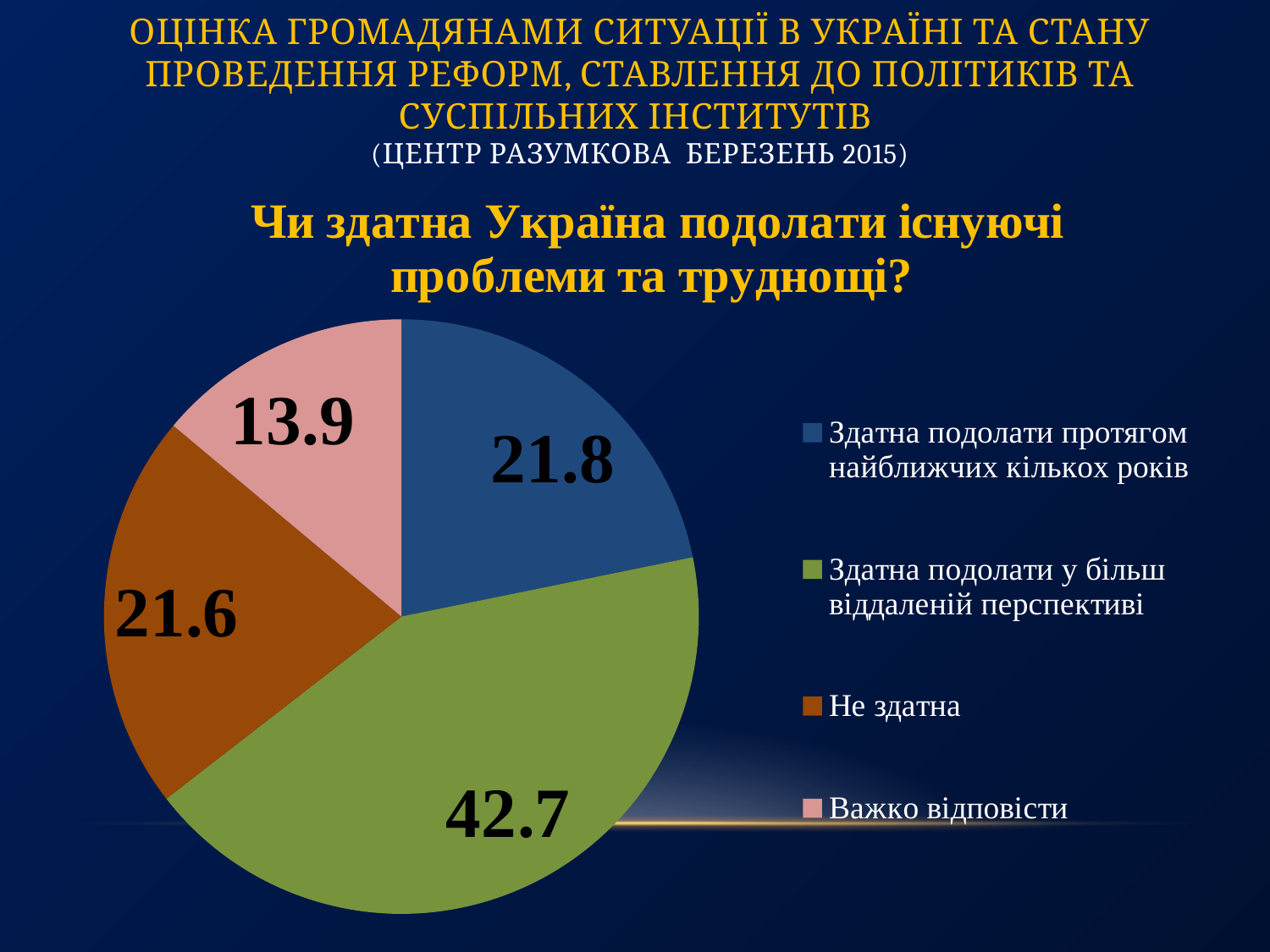
Which category has the largest slice of the pie? Здатна подолати у більш віддаленій перспективі Which is larger: the slice for "Здатна подолати у більш віддаленій перспективі" or the slice for "Не здатна"? Здатна подолати у більш віддаленій перспективі What is the difference between the values for "Здатна подолати у більш віддаленій перспективі" and "Не здатна"? 21.1 What kind of chart is shown on the slide? Pie chart What value is shown for the slice "Здатна подолати протягом найближчих кількох років"? 21.8 What value is shown for the slice "Здатна подолати у більш віддаленій перспективі"? 42.7 What colour is the slice for "Не здатна"? Brown How many slices does the pie chart have? 4 What is the difference between the values for "Здатна подолати протягом найближчих кількох років" and "Важко відповісти"? 7.9 What value is shown for the slice "Важко відповісти"? 13.9 What value is shown for the slice "Не здатна"? 21.6 Which category has the smallest slice of the pie? Важко відповісти